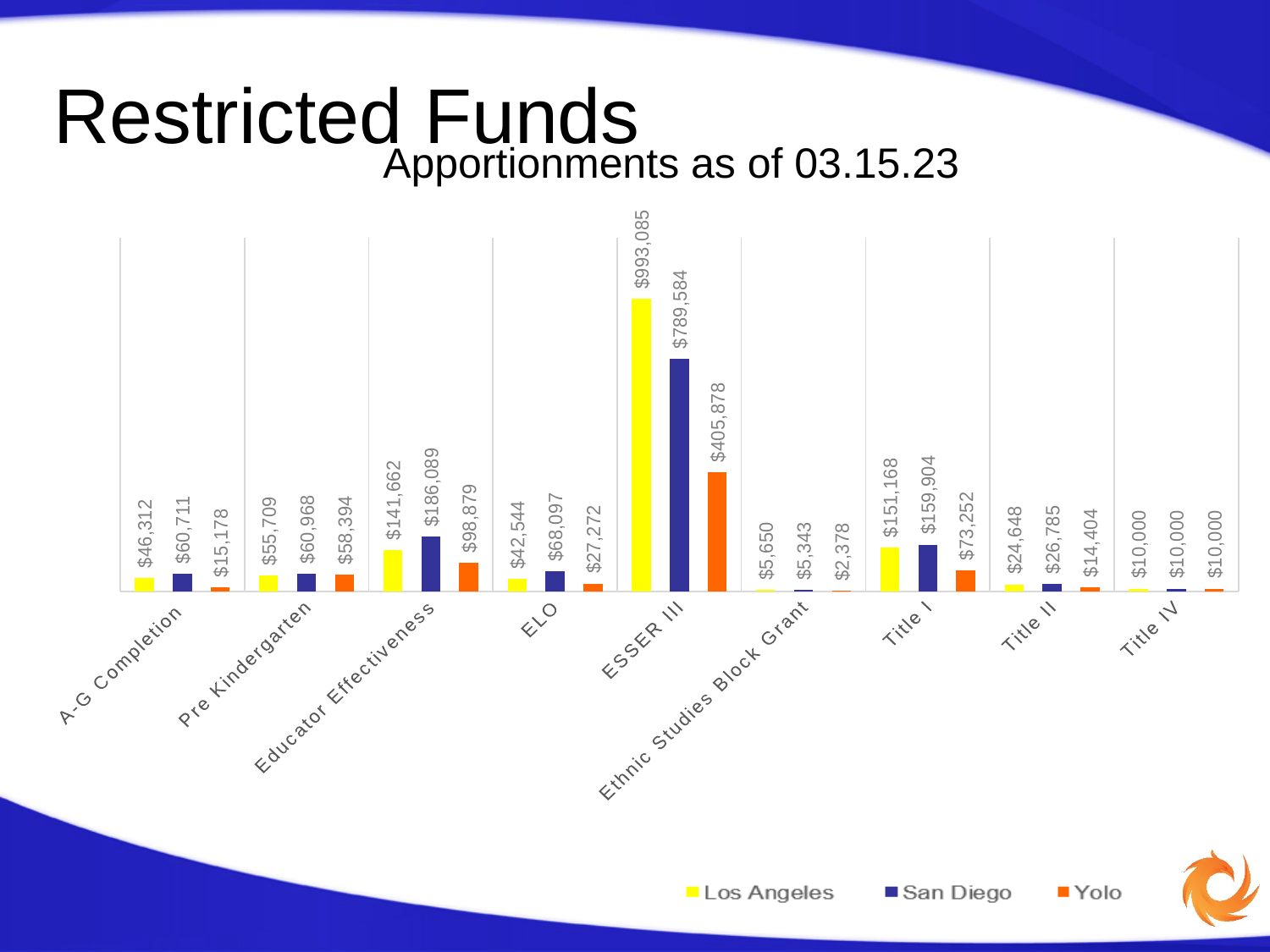
For Educator Effectiveness, which is larger: the Los Angeles value or the San Diego value? San Diego What is the Yolo value for Educator Effectiveness? $98,879 What is the subtitle shown above the chart? Apportionments as of 03.15.23 What is the difference between the San Diego and Yolo values for A-G Completion? $45,533 What is the difference between the Los Angeles and San Diego values for ESSER III? $203,501 What is the Los Angeles value for ESSER III? $993,085 What kind of chart is shown on the slide? Bar chart How many series does the legend list? 3 Which category has the highest Los Angeles value? ESSER III What is the San Diego value for Title I? $159,904 Which category has the lowest Yolo value? Ethnic Studies Block Grant How many categories are shown on the x axis? 9